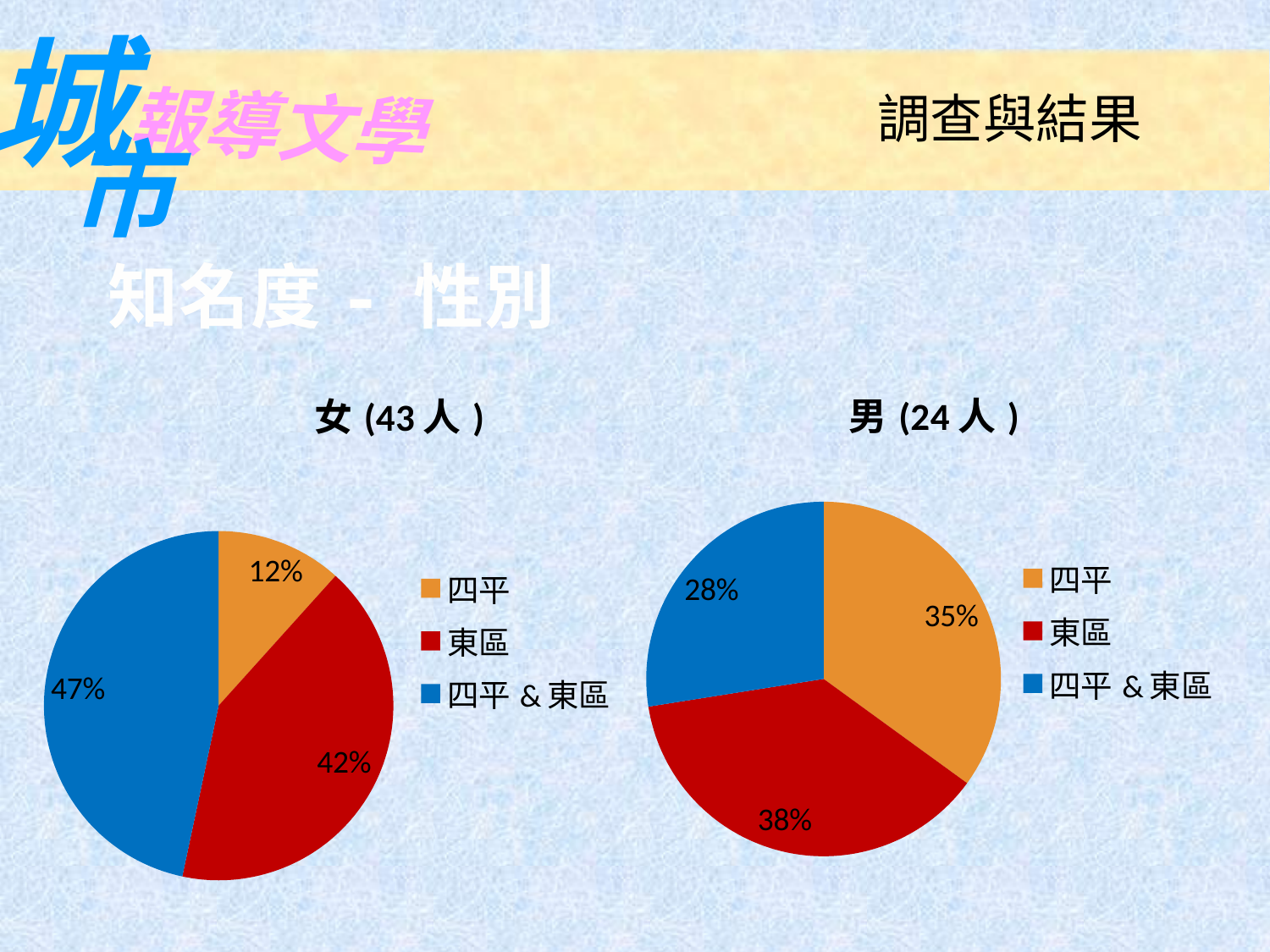
In the 女 (43 人) pie chart, what percentage is shown for 東區? 42% In the 男 (24 人) pie chart, which category has the smallest share? 四平 & 東區 In the 男 (24 人) pie chart, what percentage is shown for 四平? 35% In the 女 (43 人) pie chart, what percentage is shown for 四平? 12% What type of chart is used on the left of the slide for 女 (43 人)? Pie chart In the 女 (43 人) pie chart, what percentage is shown for 四平 & 東區? 47% In the 女 (43 人) pie chart, which category has the largest share? 四平 & 東區 In the 男 (24 人) pie chart, what percentage is shown for 四平 & 東區? 28% How many categories does the legend of the 男 (24 人) pie chart list? 3 In the 女 (43 人) pie chart, which category has the smallest share? 四平 In the 女 (43 人) pie chart, what is the difference in percentage points between 東區 and 四平? 30 In the 男 (24 人) pie chart, what percentage is shown for 東區? 38%